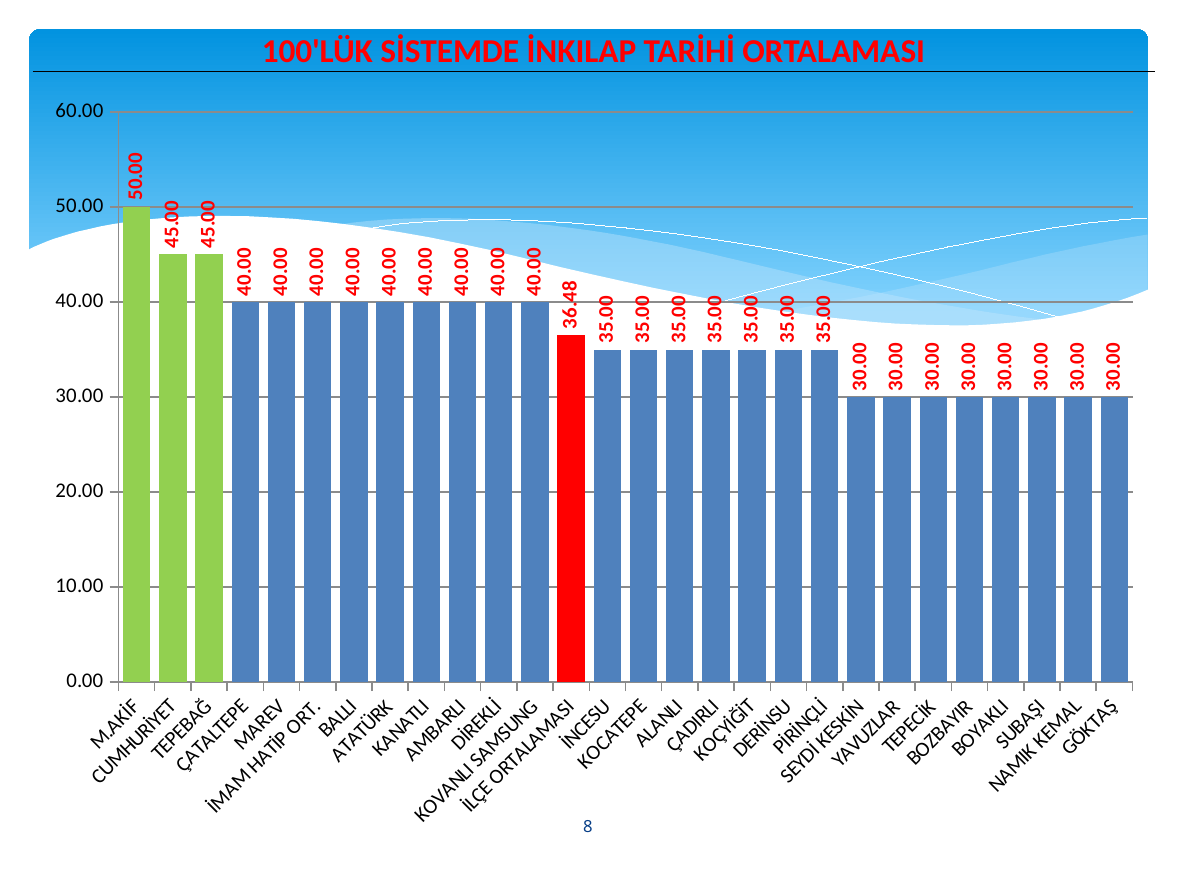
What is the difference between the values for M.AKİF and İLÇE ORTALAMASI? 13.52 What is the value for GÖKTAŞ? 30.00 What is the title of the chart? 100'LÜK SİSTEMDE İNKILAP TARİHİ ORTALAMASI Which category has the highest value? M.AKİF What is the value for İLÇE ORTALAMASI? 36.48 What is the value for M.AKİF? 50.00 What is the value for KOÇYİĞİT? 35.00 Do the values generally rise or fall from left to right along the x axis? Fall What kind of chart is shown on the slide? Bar chart What is the difference between the values for CUMHURİYET and SEYDİ KESKİN? 15.00 How many categories are shown on the x axis? 28 Which is larger, the value for ÇATALTEPE or the value for İNCESU? ÇATALTEPE